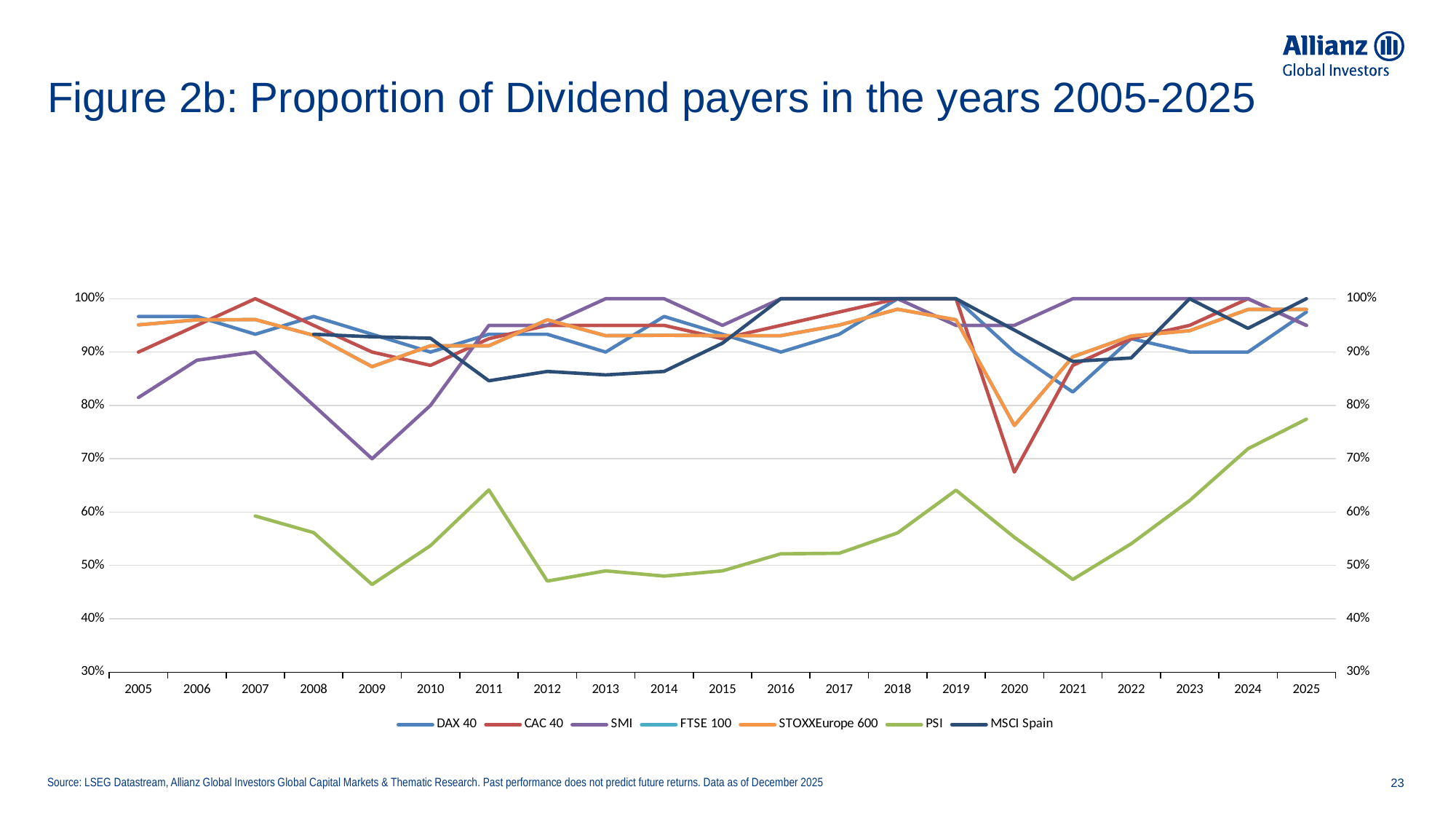
Is the value for MSCI Spain in 2011 greater or less than 90%? less What is the title of the chart? Figure 2b: Proportion of Dividend payers in the years 2005-2025 Is the value for PSI in 2025 greater or less than 70%? greater Does the PSI line rise or fall from 2021 to 2025? rise Is the value for CAC 40 in 2020 greater or less than 70%? less In 2009, which is higher: SMI or PSI? SMI How many years are shown on the x axis? 21 What kind of chart is shown on the slide? Line chart In 2020, which is higher: CAC 40 or STOXXEurope 600? STOXXEurope 600 How many series does the legend list? 7 Which series has the lowest values across the whole chart? PSI